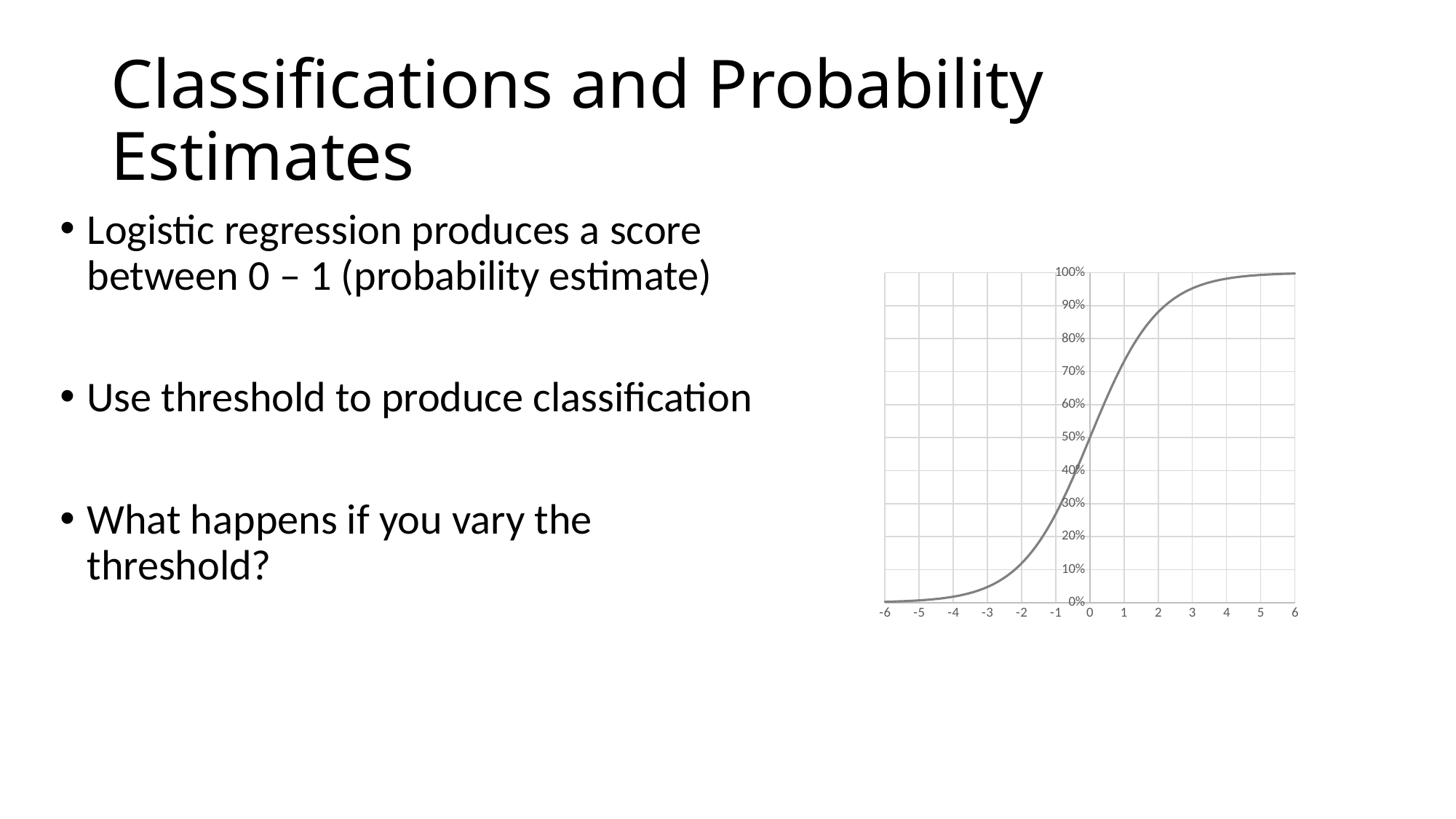
What value does the curve reach at x = 0? 50% Is the value of the curve at x = -1 greater or less than 40%? less Is the value of the curve at x = -2 greater or less than 20%? less What kind of chart is shown on the slide? line chart Is the value of the curve at x = 1 greater or less than 60%? greater Which is larger, the value of the curve at x = 2 or at x = -2? x = 2 At which x value does the curve reach its highest point? 6 What is the range of the x axis on the chart? -6 to 6 Do the values on the chart rise or fall as x increases from -6 to 6? rise